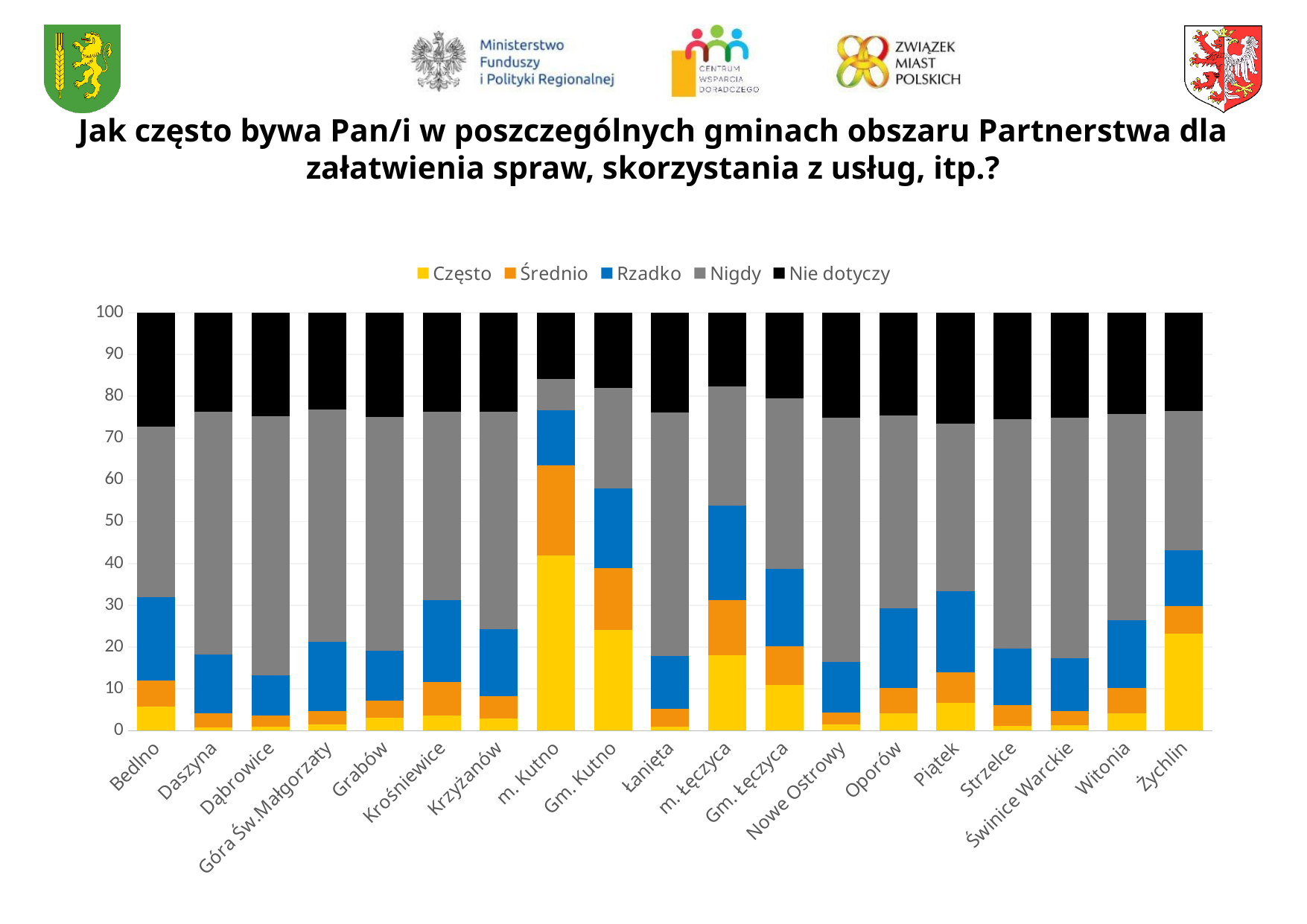
Which category has the highest value for the Często series? m. Kutno Which series is shown in black? Nie dotyczy Is the Często value for Daszyna greater or less than 10? less Which has the larger Często value, m. Kutno or Gm. Kutno? m. Kutno Is the Często value for m. Kutno greater or less than 30? greater How many municipalities (categories) are shown on the x axis? 19 What kind of chart is shown on the slide? stacked bar chart Which series is listed first in the legend? Często What is the total of the stacked bar for Bedlno? 100 How many series does the legend list? 5 Which has the larger Często value, m. Łęczyca or Nowe Ostrowy? m. Łęczyca Is the Często value for Żychlin greater or less than 20? greater